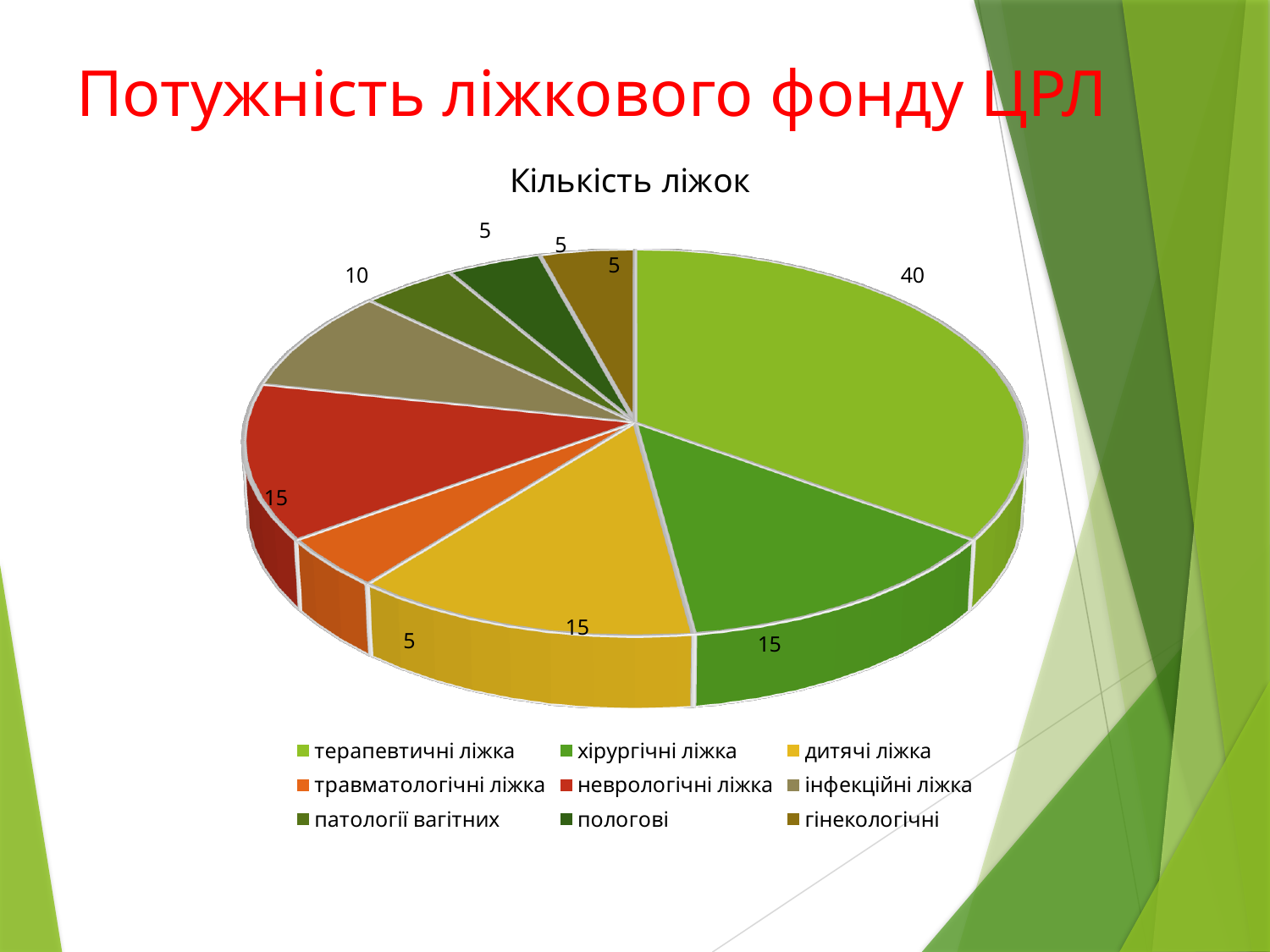
What kind of chart is shown on the slide? pie chart What is the difference between the values for терапевтичні ліжка and інфекційні ліжка? 30 What is the total of all the values in the pie chart? 115 What is the value for неврологічні ліжка? 15 What is the value for терапевтичні ліжка? 40 How many categories does the pie chart show? 9 What is the value for інфекційні ліжка? 10 What is the value for травматологічні ліжка? 5 Which category has the highest value? терапевтичні ліжка Which is larger, хірургічні ліжка or травматологічні ліжка? хірургічні ліжка What is the title of the chart? Кількість ліжок What is the difference between the values for неврологічні ліжка and пологові? 10